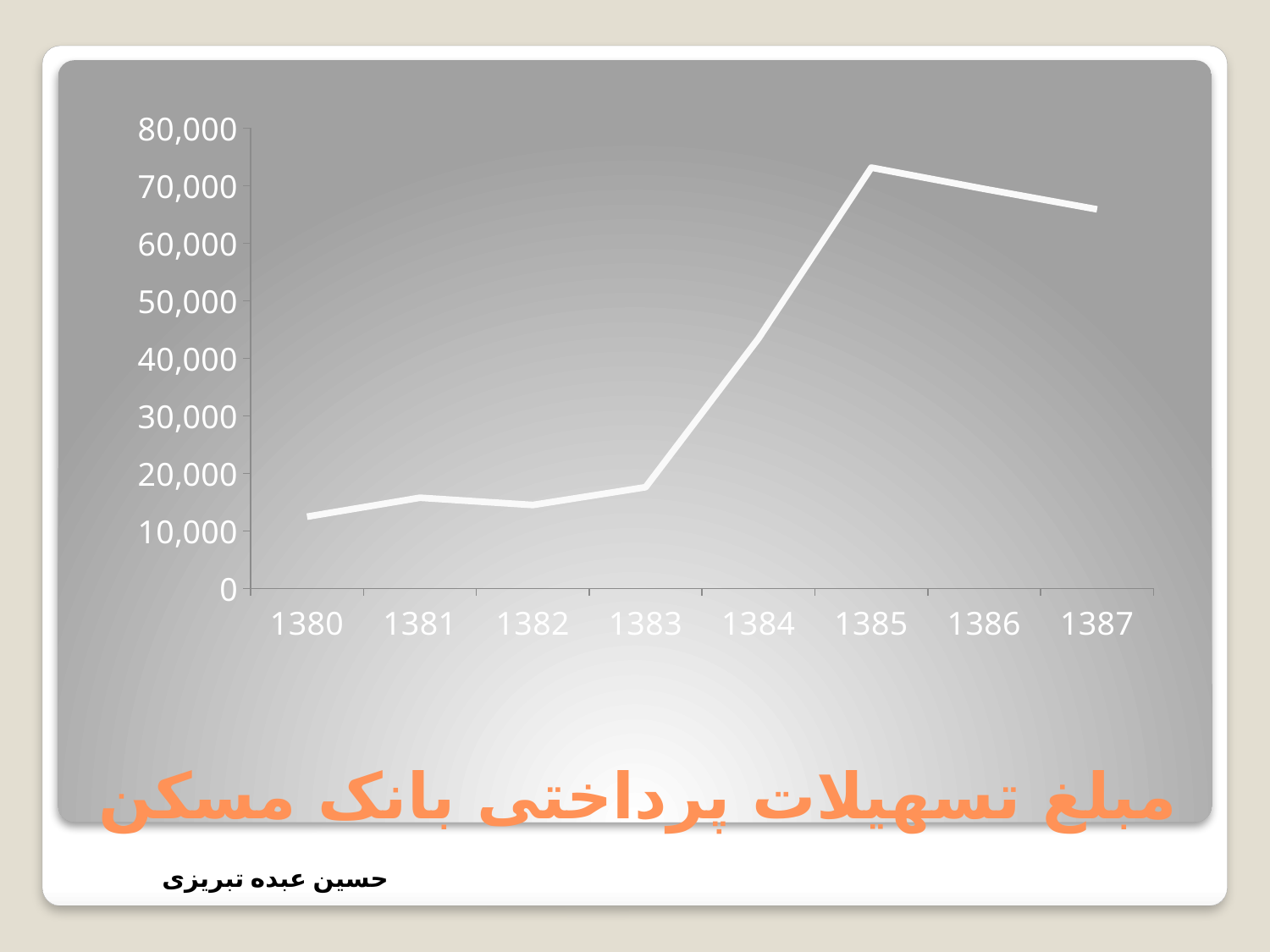
Which is larger, the value for 1383 or the value for 1384? 1384 What kind of chart is shown on the slide? line chart Which year has the highest value? 1385 Is the value for 1387 greater or less than 60,000? greater Is the value for 1380 greater or less than 20,000? less Is the value for 1384 greater or less than 30,000? greater What is the title shown on the slide for this chart? مبلغ تسهیلات پرداختی بانک مسکن Which is larger, the value for 1385 or the value for 1387? 1385 How many years are plotted along the x axis? 8 Which year has the lowest value? 1380 Does the line rise or fall between 1385 and 1387? fall